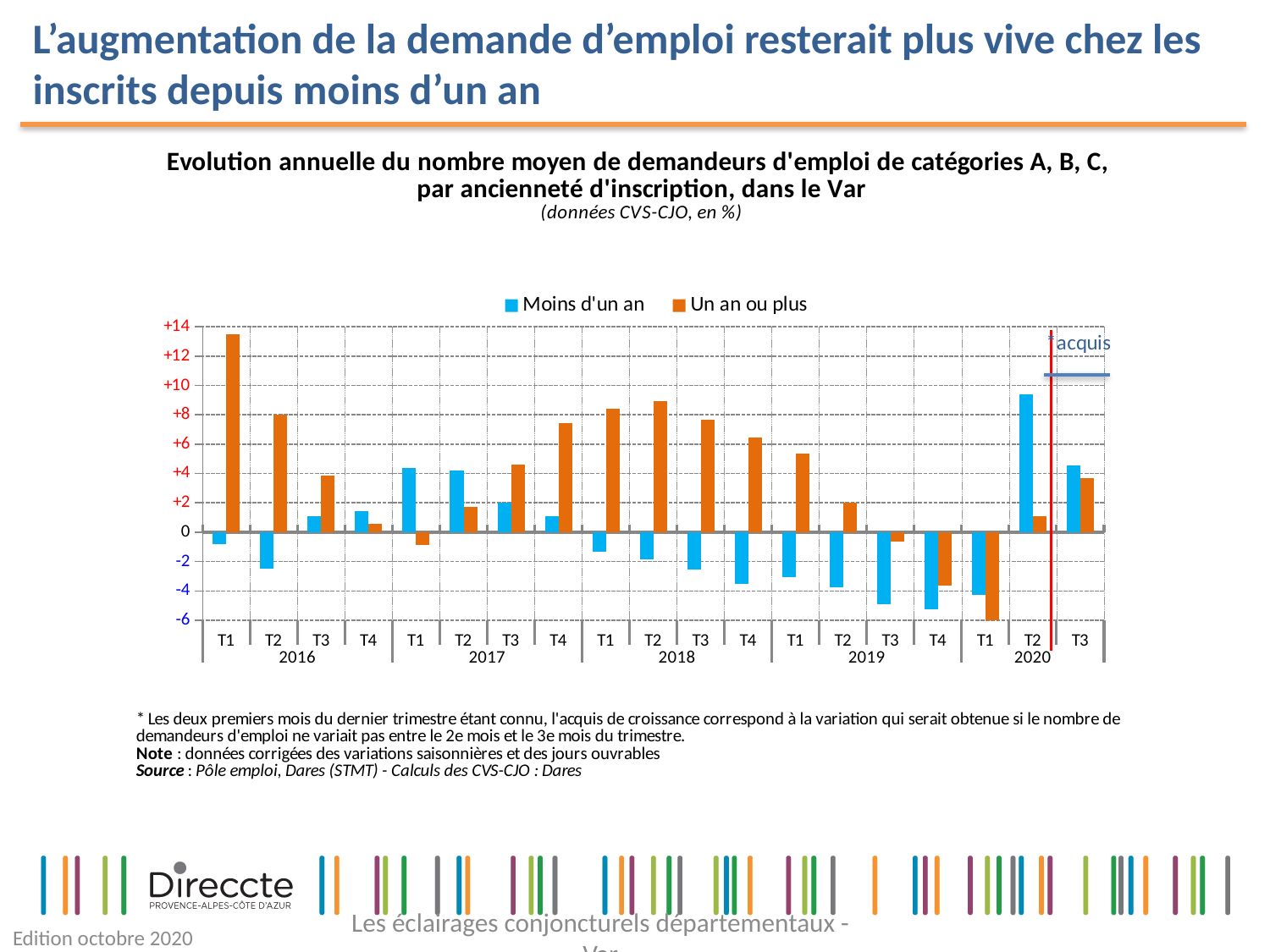
How many series does the legend list? 2 Is the value for 'Moins d'un an' in T2 2020 greater or less than +8? greater In which quarter is the value for 'Un an ou plus' the highest? T1 2016 In T1 2018, which series has the larger value, 'Moins d'un an' or 'Un an ou plus'? Un an ou plus Which colour represents the 'Moins d'un an' series? blue In which quarter is the value for 'Un an ou plus' the lowest? T1 2020 Is the value for 'Un an ou plus' in T1 2016 greater or less than +12? greater Is the value for 'Un an ou plus' in T1 2020 greater or less than -4? less In which quarter is the value for 'Moins d'un an' the highest? T2 2020 What kind of chart is shown on the slide? bar chart Do the values for 'Un an ou plus' rise or fall from T2 2018 to T1 2020? fall How many quarters are plotted along the x axis? 19